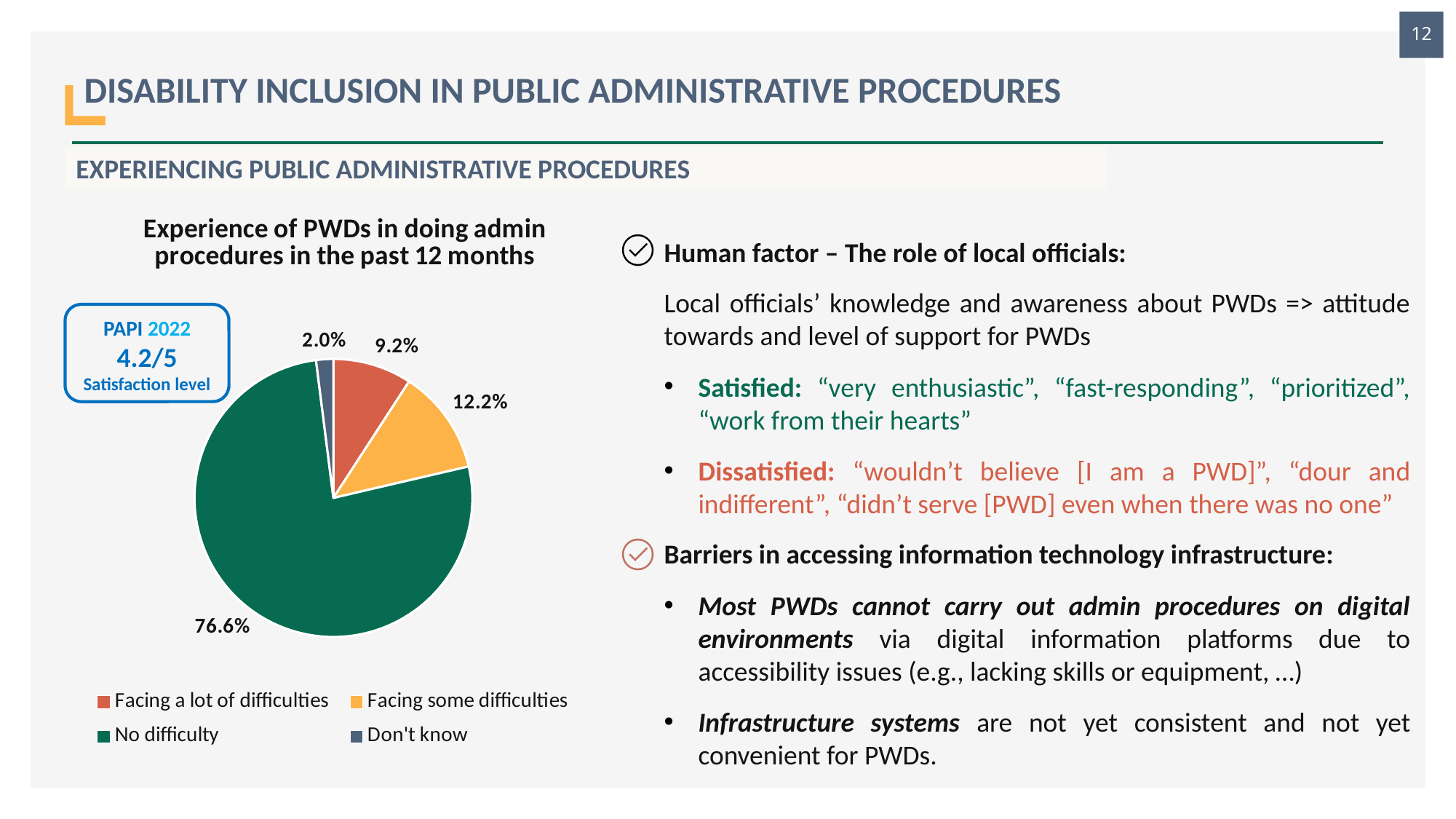
What percentage of PWDs reported facing some difficulties? 12.2% What kind of chart is shown on the slide? Pie chart What percentage of PWDs reported facing a lot of difficulties? 9.2% How many categories does the pie chart show? 4 Which category has the largest share of the pie? No difficulty Which category has the smallest share of the pie? Don't know What percentage of PWDs answered 'Don't know'? 2.0% Which is larger: the share for 'Facing some difficulties' or 'Facing a lot of difficulties'? Facing some difficulties What percentage of PWDs reported no difficulty? 76.6% What is the difference between the 'Facing some difficulties' share and the 'Facing a lot of difficulties' share? 3.0% What colour is the 'No difficulty' slice? Green What is the title of the chart? Experience of PWDs in doing admin procedures in the past 12 months